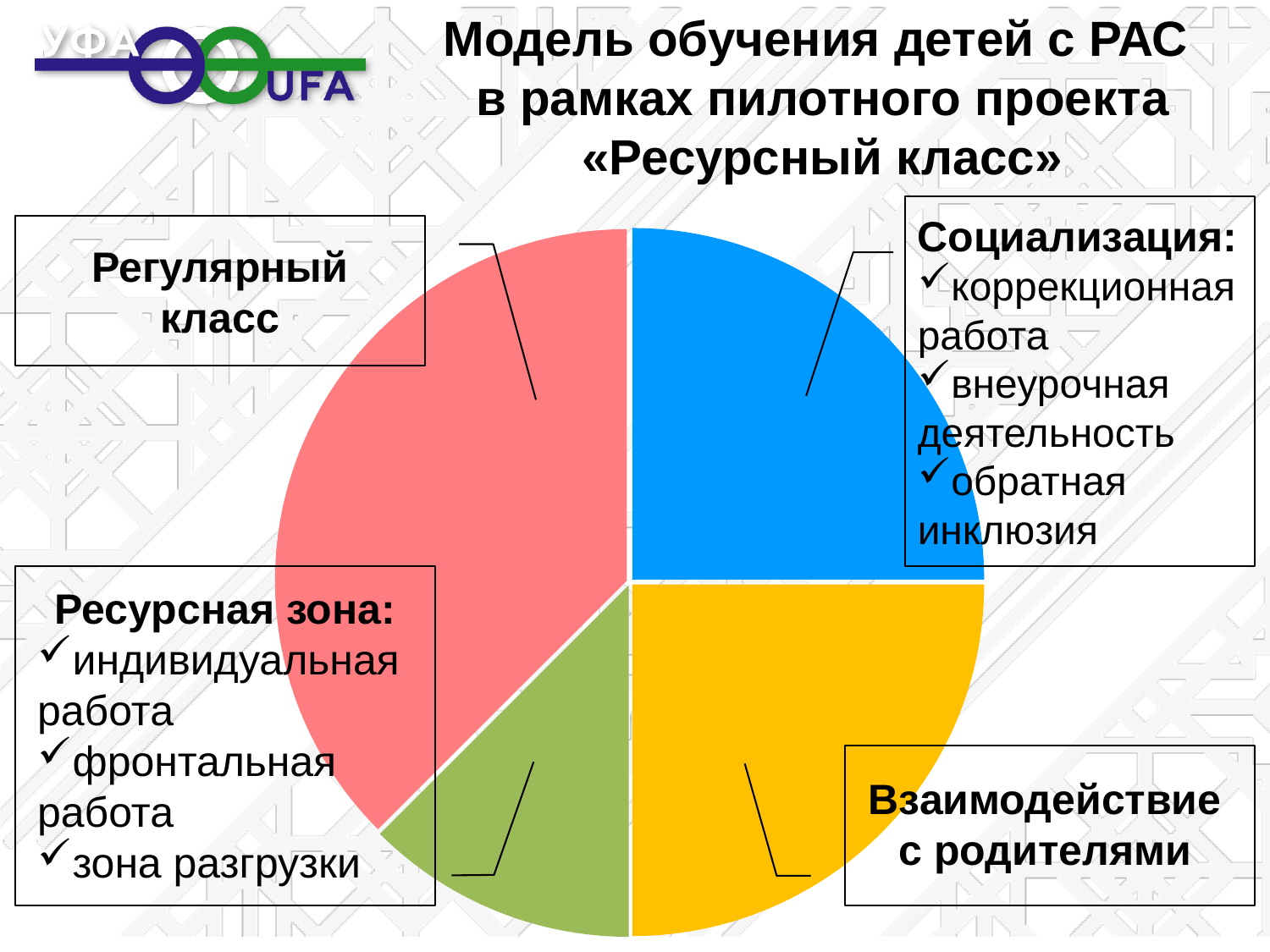
Which slice is larger, Взаимодействие с родителями or Ресурсная зона? Взаимодействие с родителями Which slice is larger, Регулярный класс or Ресурсная зона? Регулярный класс Which slice is larger, Регулярный класс or Социализация? Регулярный класс How many slices does the pie chart have? 4 What kind of chart is shown on the slide? pie chart Which slice of the pie chart is the largest? Регулярный класс Which slice of the pie chart is coloured green? Ресурсная зона Which slice of the pie chart is the smallest? Ресурсная зона What colour is the slice labelled Социализация? blue